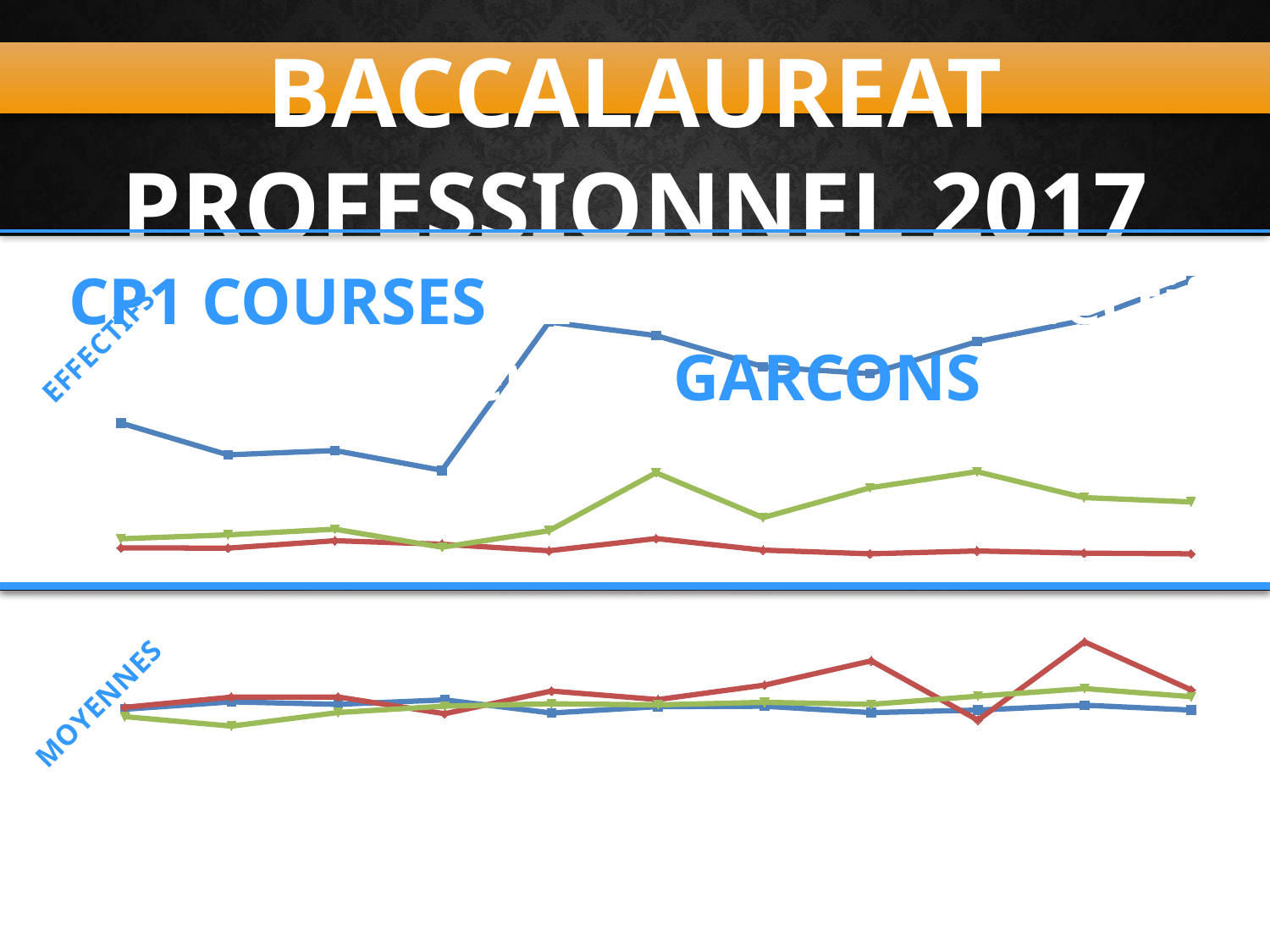
How many data points does each line in the lower chart (MOYENNES) have? 11 What kind of chart is the lower chart (labelled MOYENNES)? line chart What rotated label appears beside the lower chart? MOYENNES In the upper chart (EFFECTIFS), which coloured line is the highest across the whole chart? blue What rotated label appears beside the upper chart? EFFECTIFS What kind of chart is the upper chart (labelled EFFECTIFS)? line chart How many lines are plotted in the lower chart (MOYENNES)? 3 In the upper chart (EFFECTIFS), does the blue line overall rise or fall from left to right? rise How many lines are plotted in the upper chart (EFFECTIFS)? 3 In the upper chart (EFFECTIFS), which coloured line is the lowest at the last point? red In the lower chart (MOYENNES), which coloured line reaches the highest point? red